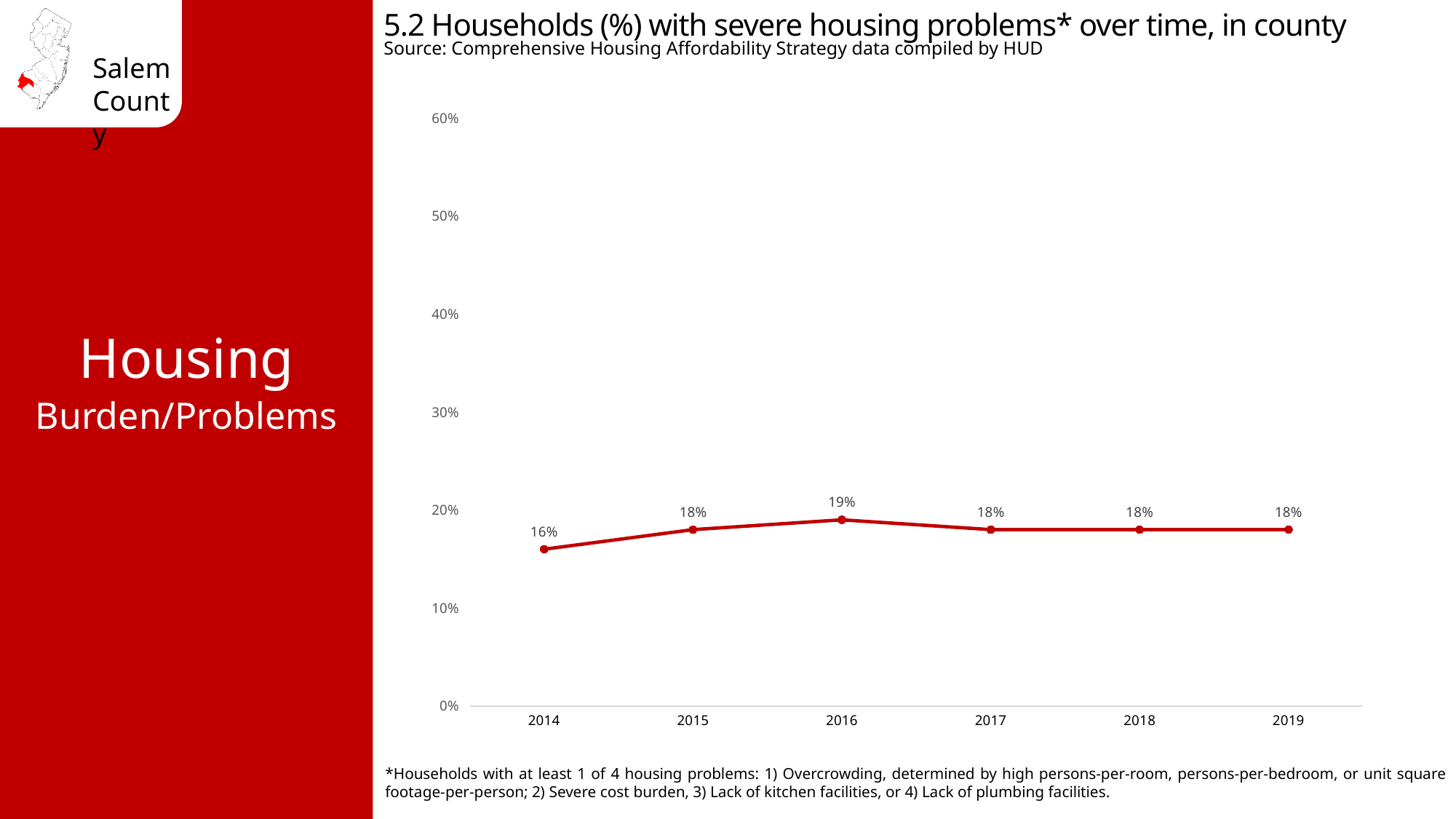
Which year has a higher value, 2014 or 2015? 2015 Did the percentage rise or fall from 2014 to 2016? rise Which year has the lowest percentage of households with severe housing problems? 2014 What is the source of the data shown in the chart? Comprehensive Housing Affordability Strategy data compiled by HUD What percentage of households had severe housing problems in 2014? 16% Which year has the highest percentage of households with severe housing problems? 2016 Is the value for 2017 greater or less than 20%? less What percentage of households had severe housing problems in 2019? 18% What is the difference in percentage points between 2016 and 2014? 3 What percentage of households had severe housing problems in 2016? 19% What kind of chart is shown on the slide? line chart How many years are plotted on the chart? 6